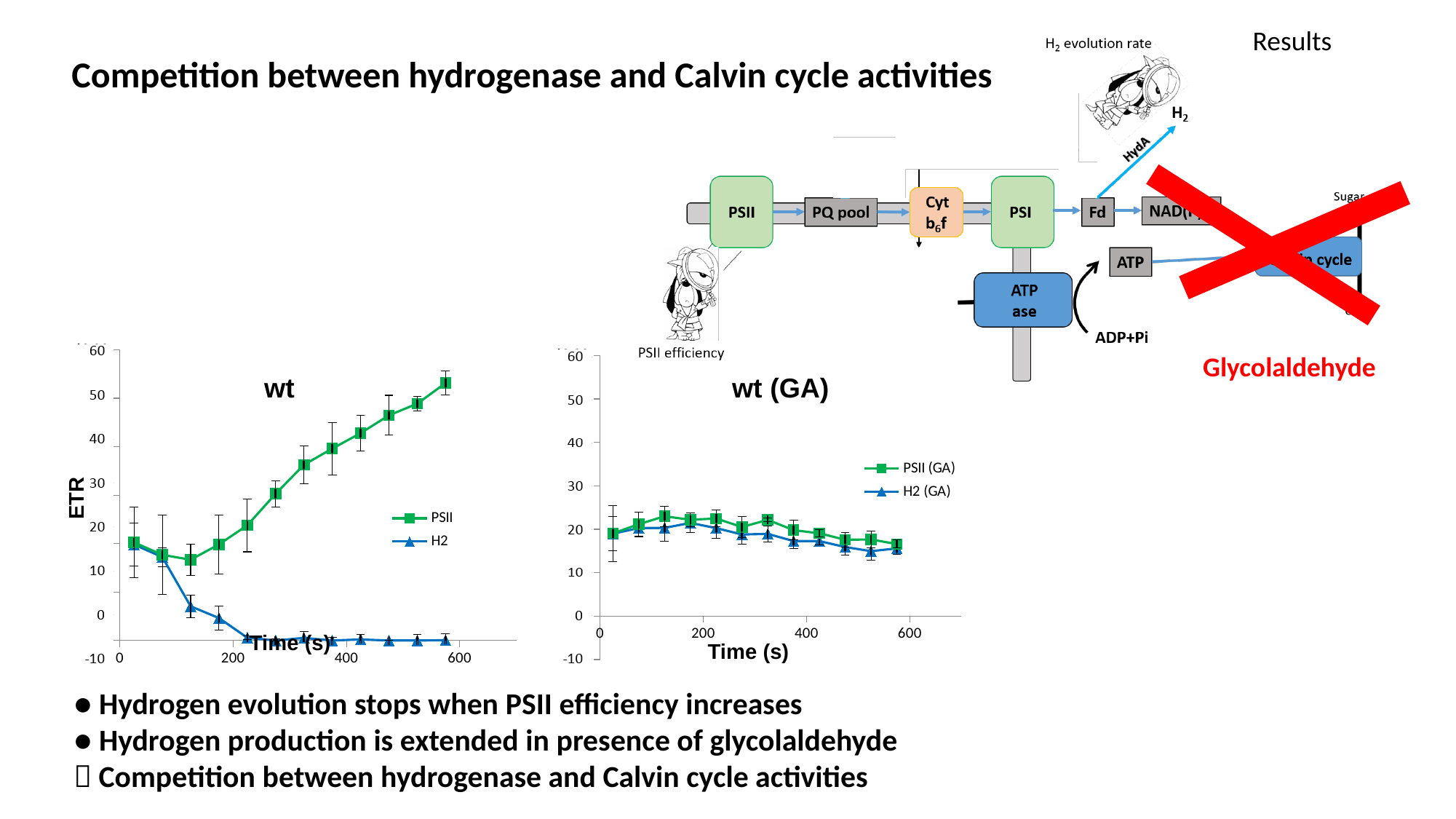
In the "wt (GA)" chart, is the H2 (GA) value at the last time point (about 575 s) greater or less than 20? less What kind of chart is the "wt" chart on the left? line chart In the "wt" chart, does the H2 series rise or fall as time increases? fall How many series does the legend of the "wt" chart list? 2 Which chart shows the larger PSII value at the last time point, "wt" or "wt (GA)"? wt In the "wt" chart, does the PSII series rise or fall as time increases? rise In the "wt" chart, is the PSII value at the last time point (about 575 s) greater or less than 40? greater In the "wt" chart, at the last time point, which series has the larger value, PSII or H2? PSII In the "wt (GA)" chart, is the PSII (GA) value at the last time point (about 575 s) greater or less than 30? less What is the label of the y axis on the "wt" chart? ETR What are the two series named in the legend of the "wt (GA)" chart? PSII (GA) and H2 (GA)